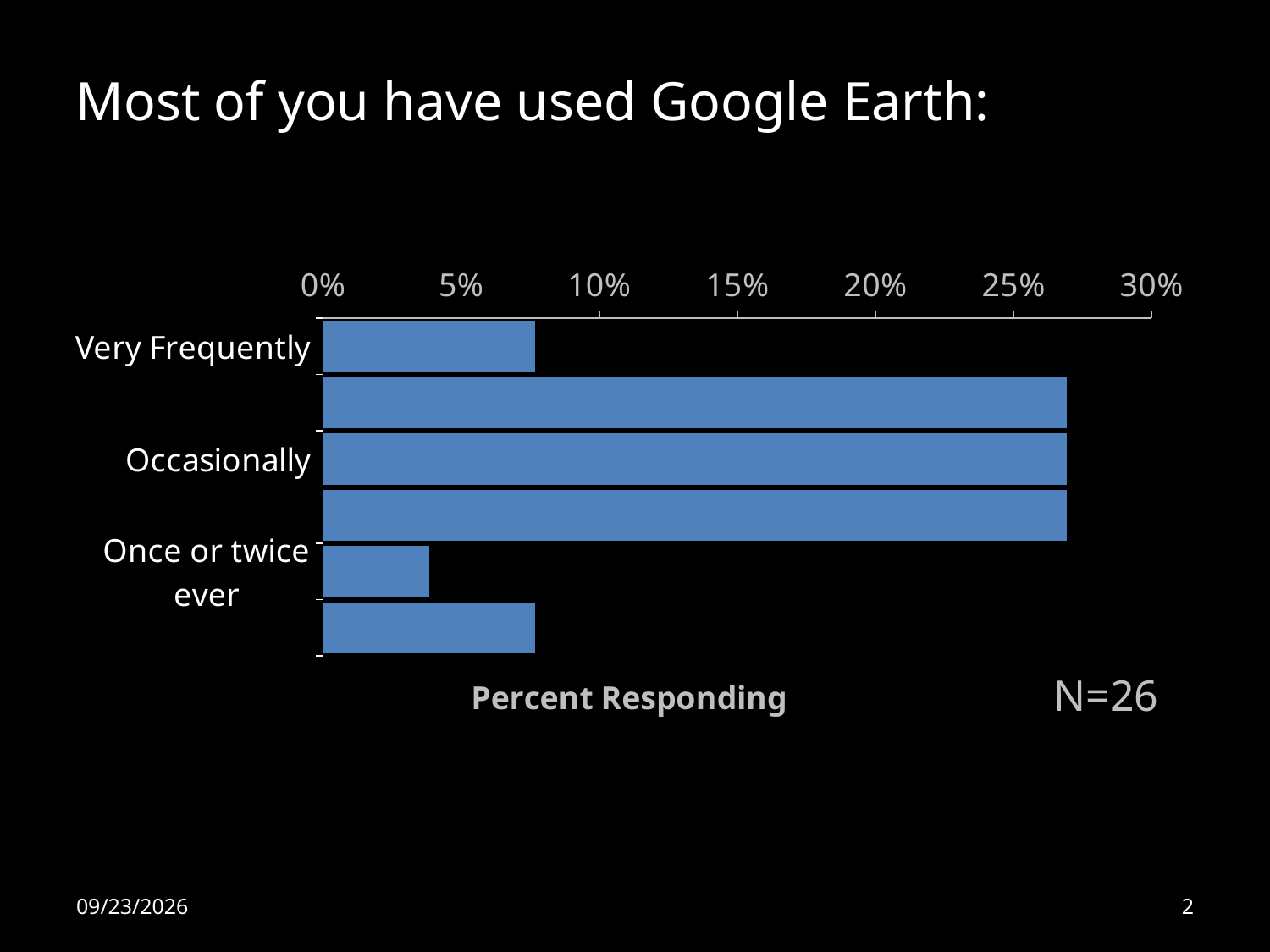
Of the labelled categories, which has the lowest value? Once or twice ever What is the title of the horizontal axis? Percent Responding Which is larger, the value for Occasionally or the value for Very Frequently? Occasionally What sample size (N) is shown next to the chart? N=26 Is the value for Occasionally greater or less than 30%? less Is the value for Occasionally greater or less than 25%? greater Is the value for Very Frequently greater or less than 10%? less What kind of chart is shown on the slide? bar chart Which is larger, the value for Very Frequently or the value for Once or twice ever? Very Frequently Of the labelled categories, which has the highest value? Occasionally